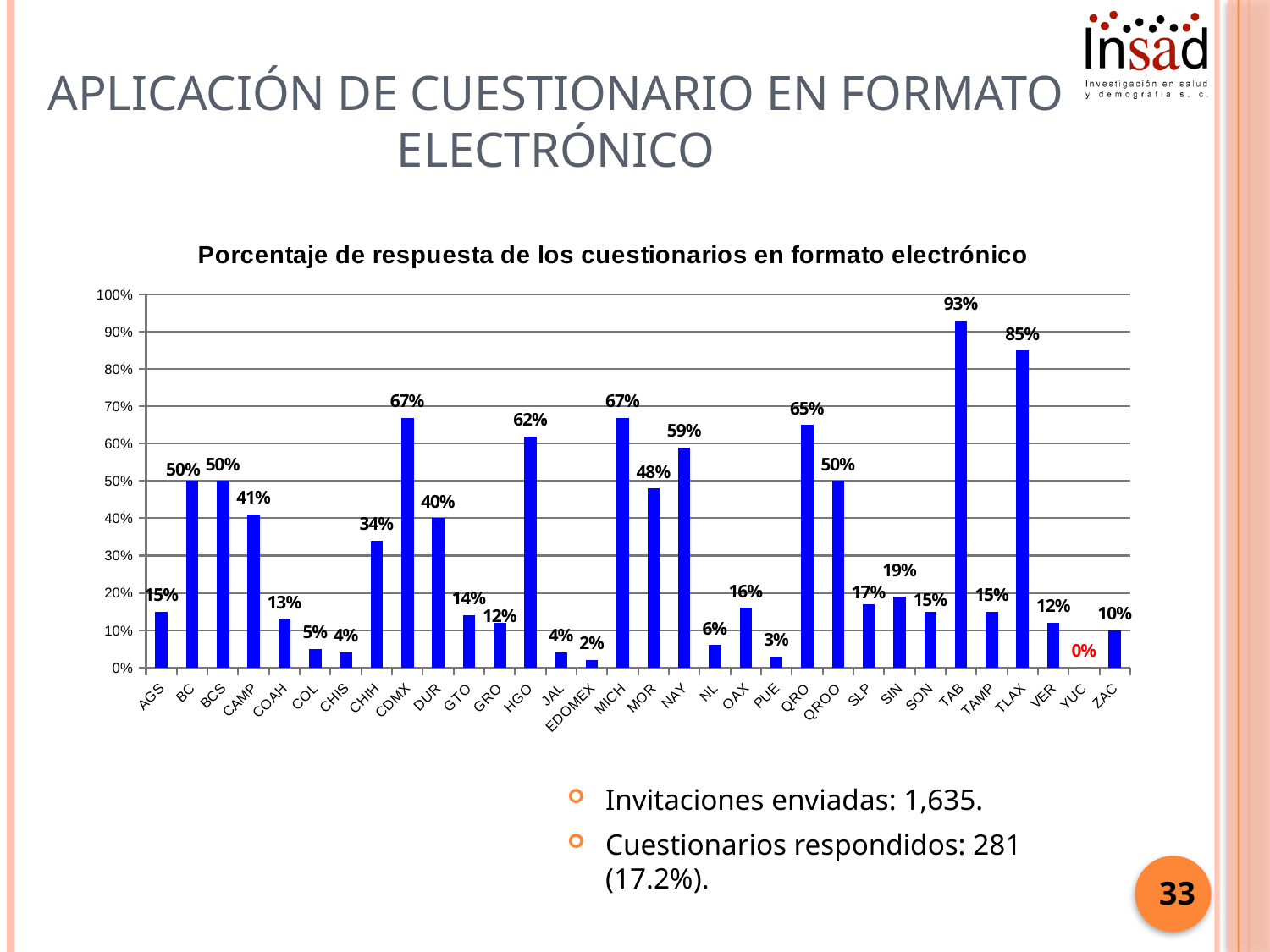
What is the difference between the response percentages of TAB and TLAX? 8% What is the title of the chart? Porcentaje de respuesta de los cuestionarios en formato electrónico Is the value for CHIH greater or less than 30%? greater How many states are shown on the x axis of the chart? 32 Which state has the lowest response percentage? YUC What is the response percentage for NAY? 59% Which state has the highest response percentage? TAB What is the response percentage for CDMX? 67% What is the response percentage for TAB? 93% Which has a higher response percentage, HGO or QRO? QRO What type of chart is shown on the slide? Bar chart What is the response percentage for EDOMEX? 2%